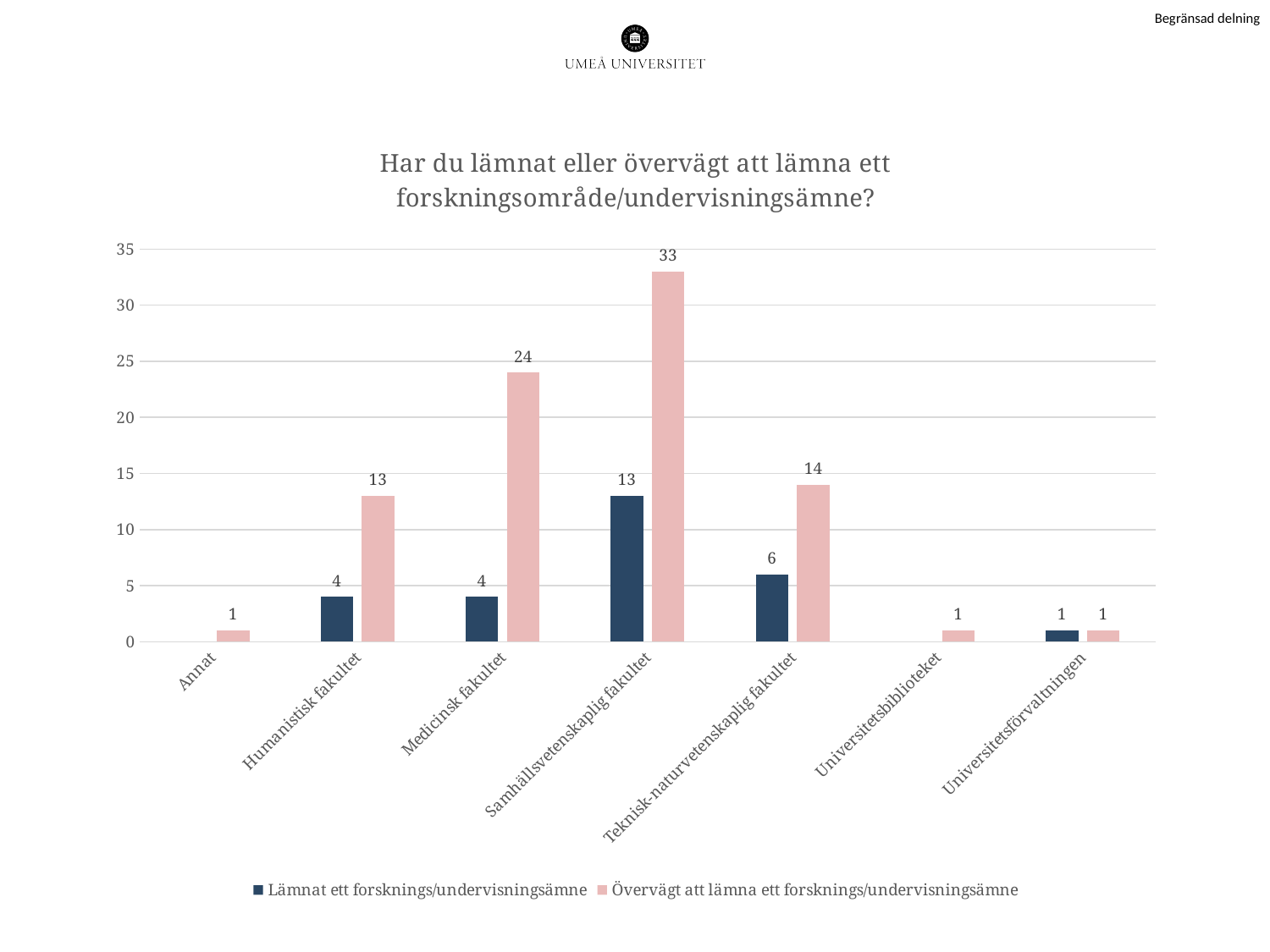
What is the value for 'Övervägt att lämna ett forsknings/undervisningsämne' for Samhällsvetenskaplig fakultet? 33 How many categories are shown on the x axis? 7 What kind of chart is shown on the slide? Bar chart Which is larger: the 'Övervägt att lämna' value for Humanistisk fakultet or for Teknisk-naturvetenskaplig fakultet? Teknisk-naturvetenskaplig fakultet How many series does the legend list? 2 Which category has the highest value for 'Övervägt att lämna ett forsknings/undervisningsämne'? Samhällsvetenskaplig fakultet What is the title of the chart? Har du lämnat eller övervägt att lämna ett forskningsområde/undervisningsämne? What is the difference between the 'Övervägt att lämna' values for Medicinsk fakultet and Humanistisk fakultet? 11 What is the value for 'Övervägt att lämna ett forsknings/undervisningsämne' for Medicinsk fakultet? 24 What is the difference between the 'Övervägt' and 'Lämnat' values for Samhällsvetenskaplig fakultet? 20 Which category has the highest value for 'Lämnat ett forsknings/undervisningsämne'? Samhällsvetenskaplig fakultet What is the value for 'Lämnat ett forsknings/undervisningsämne' for Teknisk-naturvetenskaplig fakultet? 6